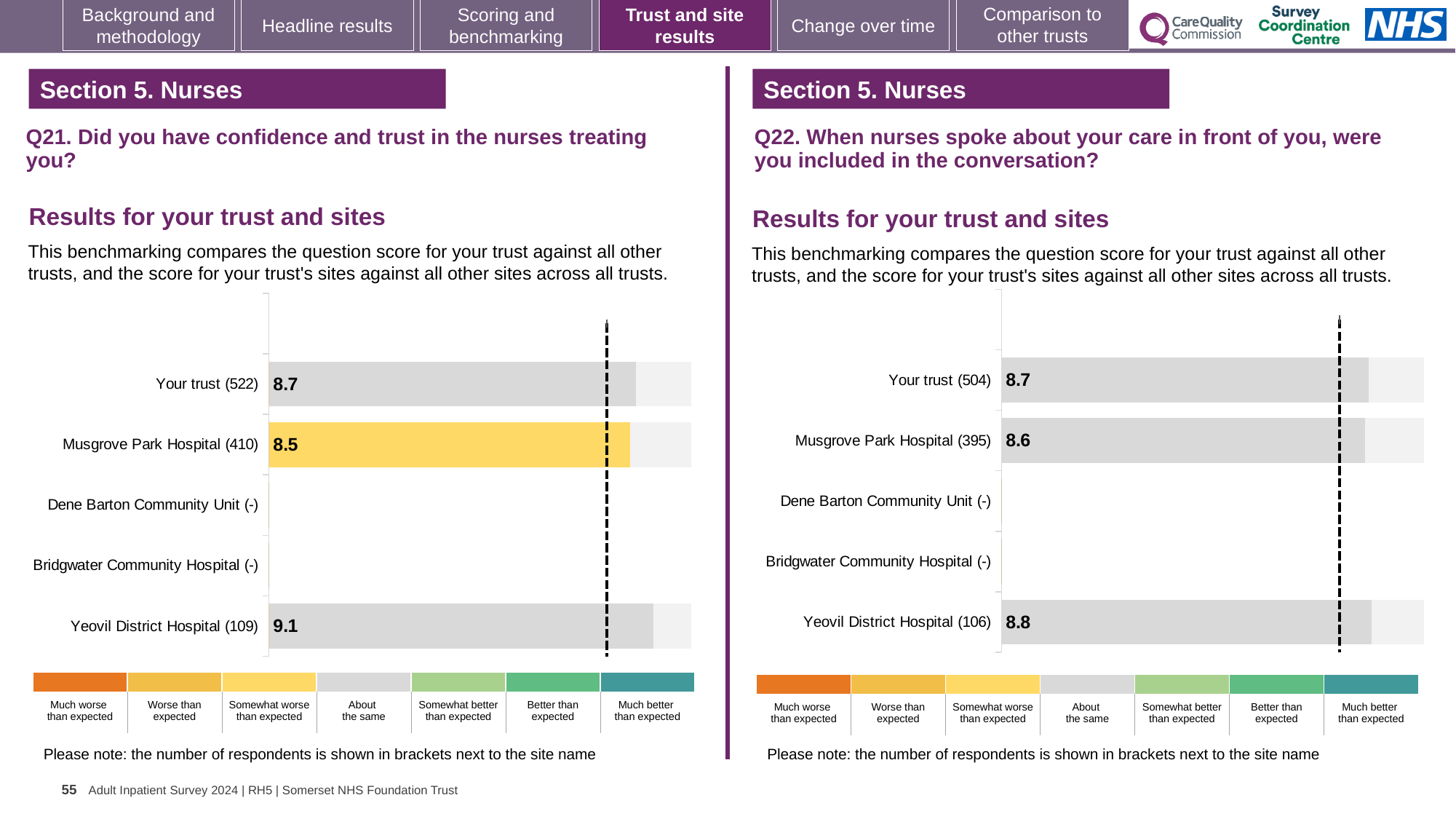
On the Q21 chart (left), what is the score for Yeovil District Hospital? 9.1 On the Q21 chart (left), how many respondents are shown for Your trust? 522 On the Q22 chart (right), what is the score for Musgrove Park Hospital? 8.6 On the Q21 chart (left), which bar is coloured yellow? Musgrove Park Hospital On the Q21 chart (left), what is the score for Musgrove Park Hospital? 8.5 On the Q21 chart (left), what is the score for Your trust? 8.7 On the Q21 chart (left), what is the difference between the Yeovil District Hospital score and the Musgrove Park Hospital score? 0.6 What kind of chart is used on the Q22 chart (right)? Bar chart On the Q22 chart (right), what is the score for Yeovil District Hospital? 8.8 On the Q22 chart (right), which has the larger score, Your trust or Musgrove Park Hospital? Your trust On the Q22 chart (right), what is the difference between the Yeovil District Hospital score and the Your trust score? 0.1 On the Q21 chart (left), which site has the highest score? Yeovil District Hospital